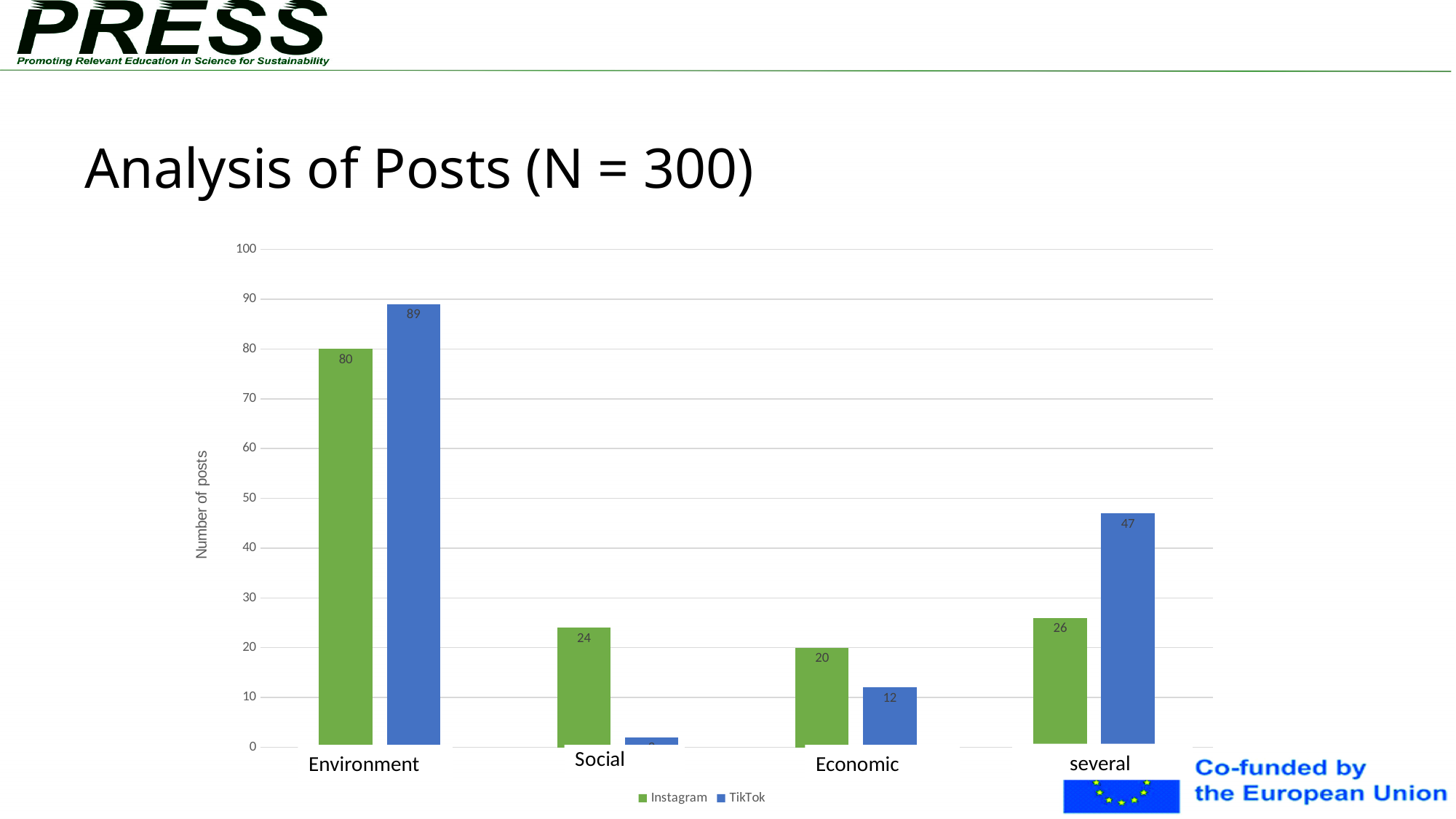
Is the value for TikTok posts in the Social category greater or less than 10? less Which category has the highest number of TikTok posts? Environment What is the number of TikTok posts for Environment? 89 Which is larger for Social: Instagram posts or TikTok posts? Instagram What type of chart is shown on the slide? Bar chart How many categories are shown on the x axis? 4 How many series does the legend list? 2 What is the number of Instagram posts for Environment? 80 What is the number of TikTok posts for several? 47 Which category has the lowest number of Instagram posts? Economic What is the number of Instagram posts for Economic? 20 What is the difference between TikTok and Instagram posts for Environment? 9